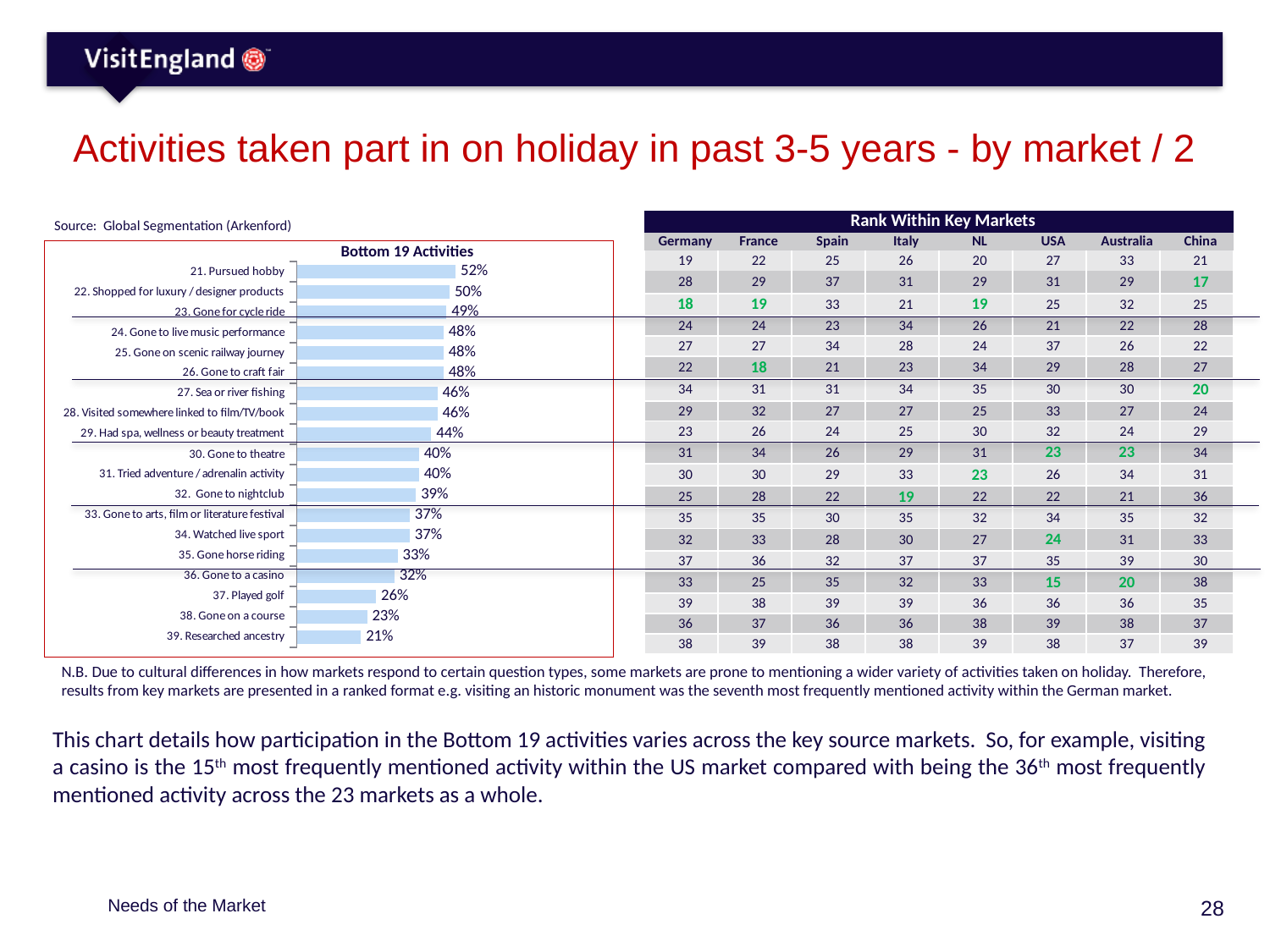
What percentage is shown for "Gone to a casino"? 32% What is the difference between the values for "Pursued hobby" and "Researched ancestry"? 31 percentage points Which activity has the highest value in the Bottom 19 Activities chart? 21. Pursued hobby What is the title of the bar chart on the slide? Bottom 19 Activities Which activity has the lowest value in the Bottom 19 Activities chart? 39. Researched ancestry Which has a higher value, "Gone for cycle ride" or "Sea or river fishing"? Gone for cycle ride What is the difference between the values for "Gone to nightclub" and "Gone horse riding"? 6 percentage points What is the value for "Pursued hobby" in the Bottom 19 Activities chart? 52% What percentage is shown for "Played golf"? 26% What type of chart is the Bottom 19 Activities chart? Bar chart How many activities are plotted in the Bottom 19 Activities chart? 19 What is the value for "Had spa, wellness or beauty treatment"? 44%